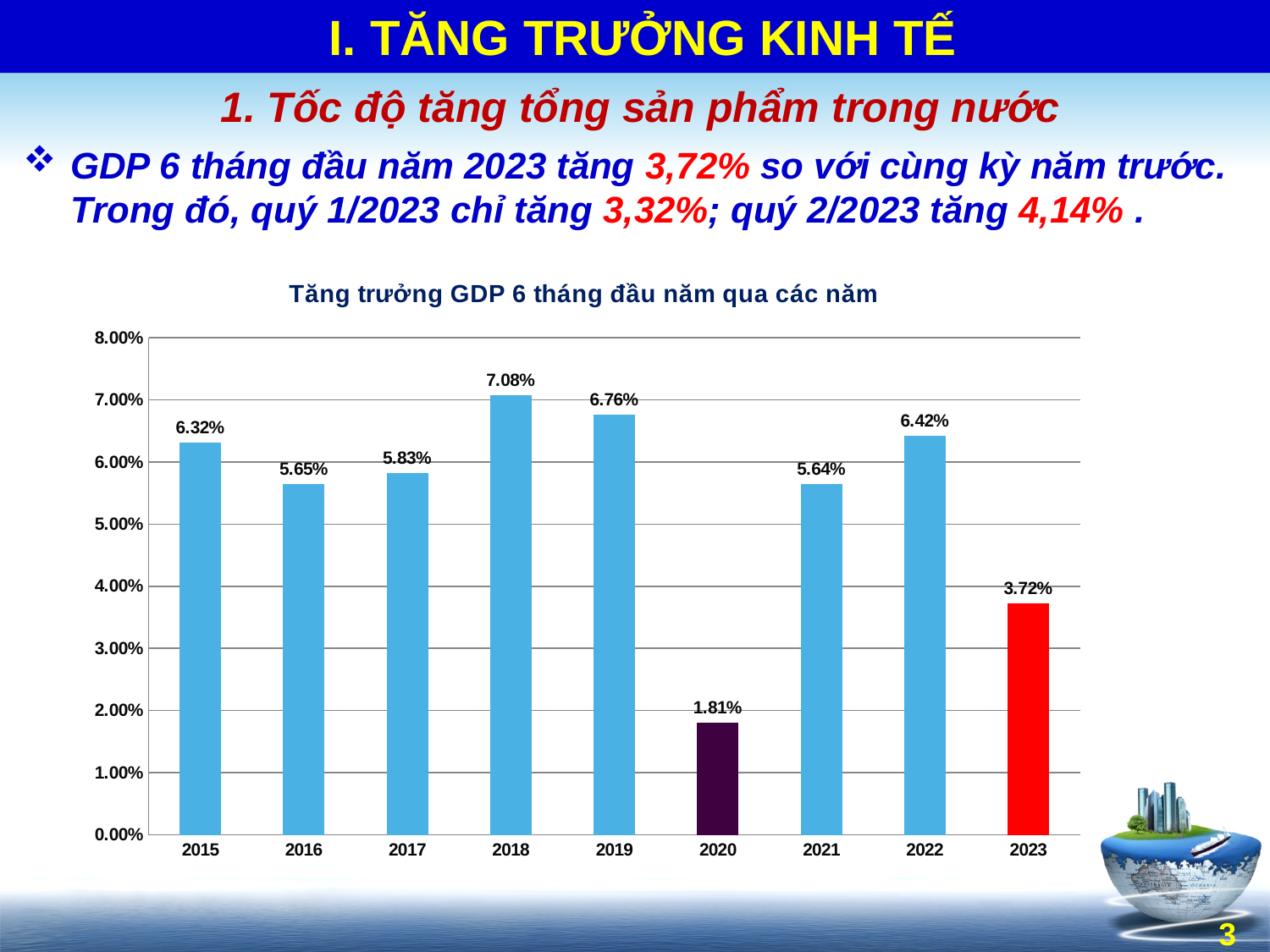
Which year has the larger value, 2015 or 2019? 2019 Which year has the highest GDP growth in the chart? 2018 Do the values rise or fall from 2021 to 2022? Rise Is the value for 2021 greater or less than 5.00%? greater What is the GDP growth value shown for 2018? 7.08% What is the title of the chart? Tăng trưởng GDP 6 tháng đầu năm qua các năm Which year has the lowest GDP growth in the chart? 2020 How many years are shown on the x axis of the chart? 9 What is the GDP growth value shown for 2023? 3.72% What is the GDP growth value shown for 2020? 1.81% What kind of chart is shown on the slide? Bar chart What is the difference between the values for 2022 and 2023? 2.70%